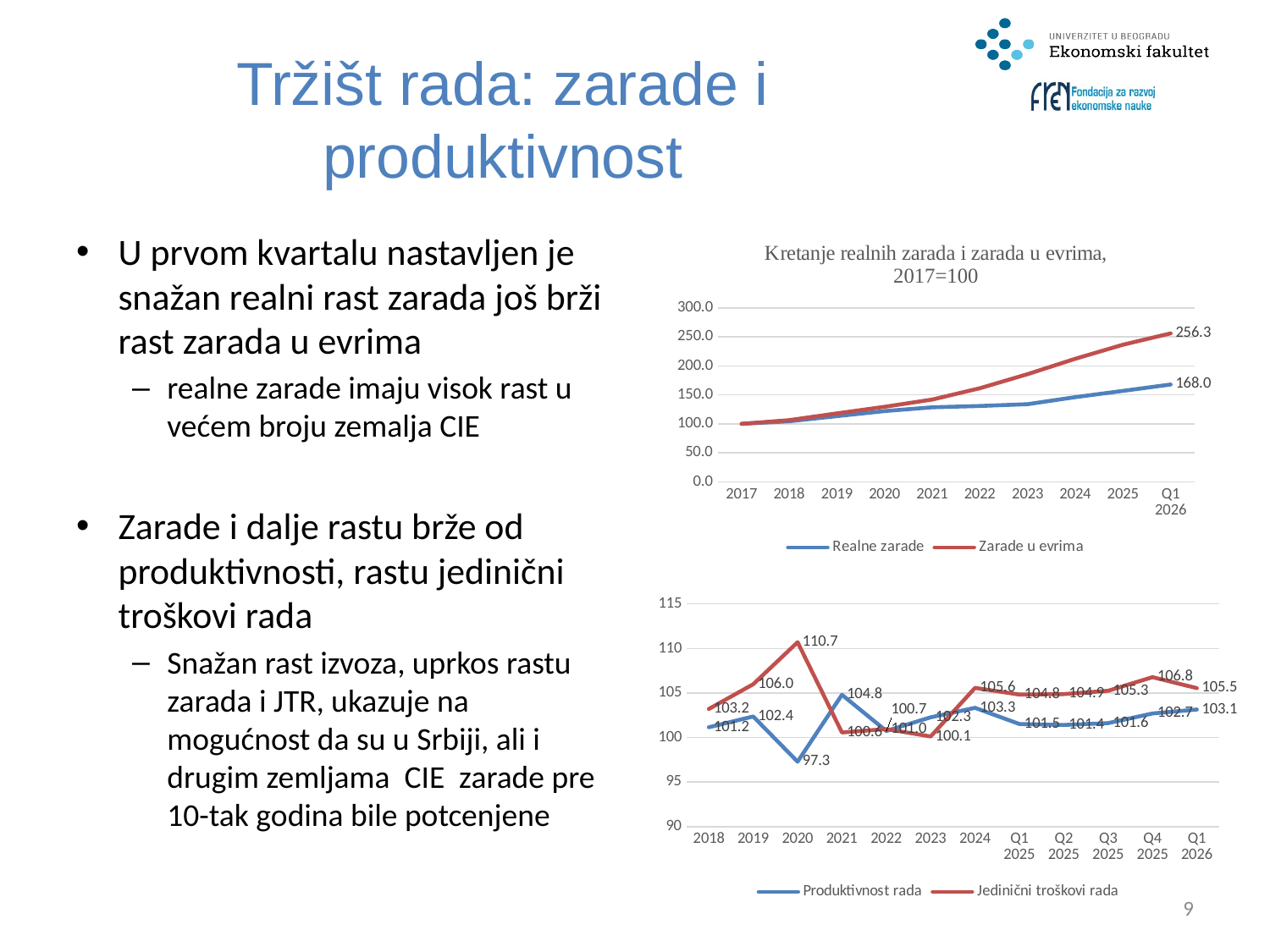
In the top chart, is the value of Realne zarade for 2023 greater or less than 150.0? less In the top chart, what is the difference between Zarade u evrima and Realne zarade in Q1 2026? 88.3 What type of chart is the top chart titled 'Kretanje realnih zarada i zarada u evrima, 2017=100'? line chart In the bottom chart, how many periods are shown on the x axis? 12 In the top chart, what is the value of Realne zarade for Q1 2026? 168.0 In the bottom chart, what is the value of Jedinični troškovi rada for 2020? 110.7 In the bottom chart, in which period is Produktivnost rada lowest? 2020 In the top chart, how many series does the legend list? 2 In the top chart, what is the value of Zarade u evrima for Q1 2026? 256.3 In the bottom chart, which is larger in Q1 2026: Produktivnost rada or Jedinični troškovi rada? Jedinični troškovi rada In the bottom chart, what is the value of Produktivnost rada for 2020? 97.3 In the bottom chart, in which period is Jedinični troškovi rada highest? 2020